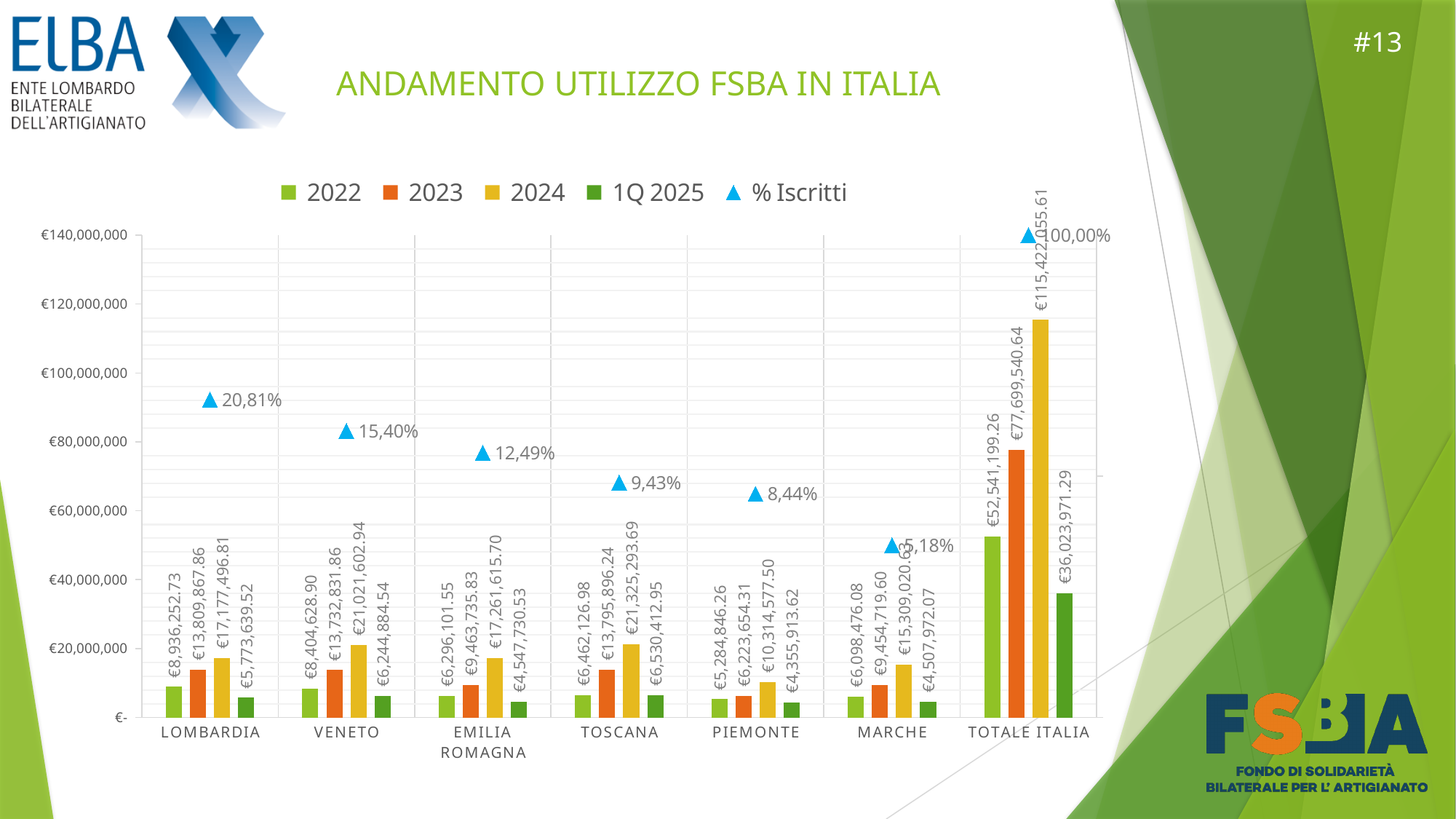
What is the 1Q 2025 value for Totale Italia? €36,023,971.29 How many categories are shown on the x axis? 7 What is the difference between the 2024 and 2022 values for Lombardia? €8,241,244.08 Which is larger, the 2024 value for Veneto or the 2024 value for Toscana? Toscana Is the 2024 value for Totale Italia greater or less than €100,000,000? greater How many series does the legend list? 5 Among the regions (excluding Totale Italia), which has the lowest 2022 value? Piemonte What is the value for Lombardia in the 2024 series? €17,177,496.81 Among the regions (excluding Totale Italia), which has the highest % Iscritti? Lombardia What is the 2023 value for Toscana? €13,795,896.24 What is the % Iscritti value for Veneto? 15,40% What is the title of the chart? ANDAMENTO UTILIZZO FSBA IN ITALIA